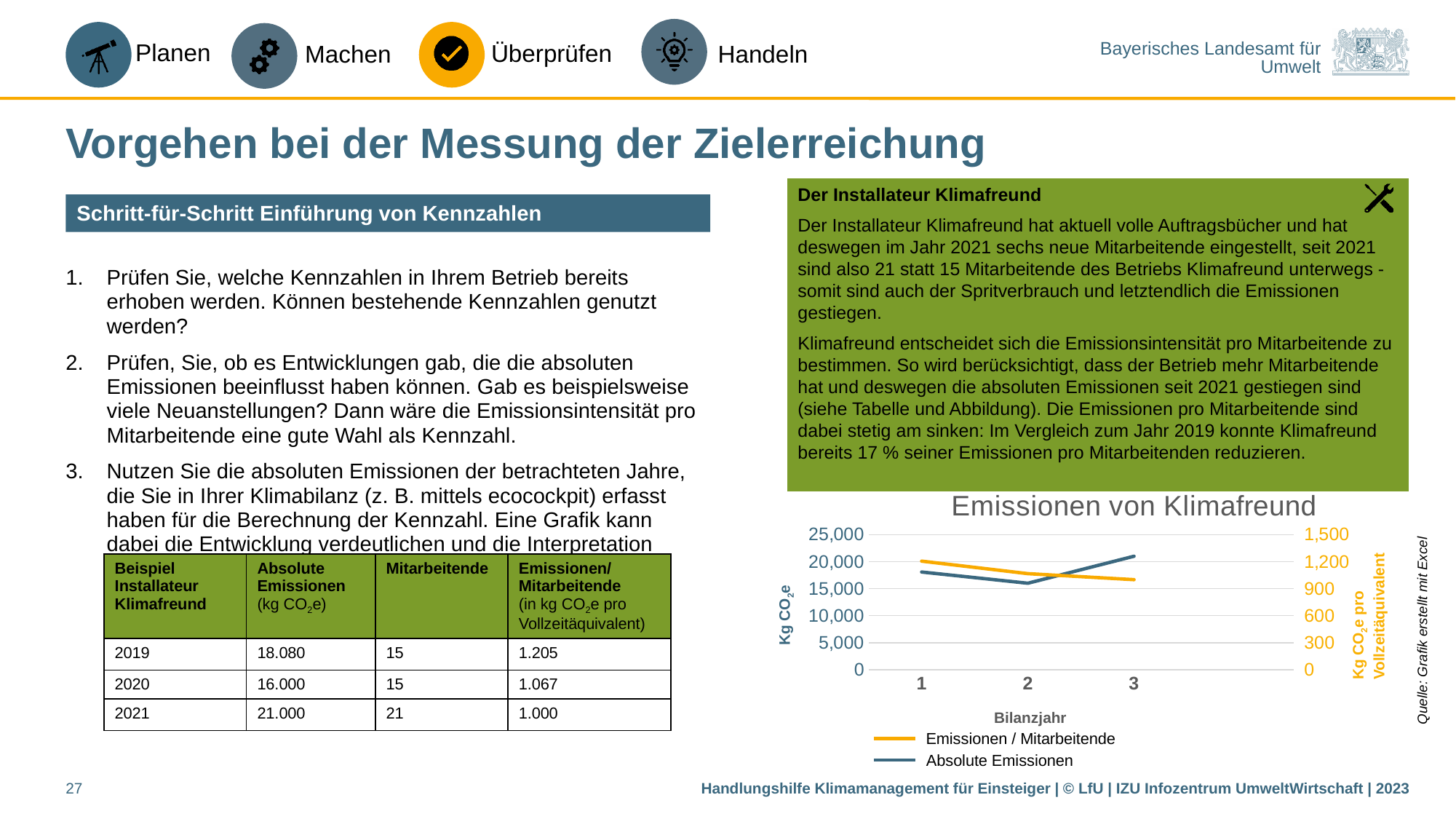
In the "Emissionen von Klimafreund" chart, is the "Emissionen / Mitarbeitende" value at Bilanzjahr 3 greater or less than 900? greater In the "Emissionen von Klimafreund" chart, what is the label of the x axis? Bilanzjahr In the "Emissionen von Klimafreund" chart, does the "Absolute Emissionen" line rise or fall from Bilanzjahr 2 to 3? rise In the "Emissionen von Klimafreund" chart, at which Bilanzjahr is "Absolute Emissionen" highest? 3 In the "Emissionen von Klimafreund" chart, is the "Absolute Emissionen" value at Bilanzjahr 3 greater or less than 20,000? greater How many series does the legend of the "Emissionen von Klimafreund" chart list? 2 How many Bilanzjahr points are plotted on the x axis of the "Emissionen von Klimafreund" chart? 3 In the "Emissionen von Klimafreund" chart, which is larger for "Absolute Emissionen": Bilanzjahr 1 or Bilanzjahr 3? Bilanzjahr 3 What type of chart is "Emissionen von Klimafreund"? line chart In the "Emissionen von Klimafreund" chart, is the "Absolute Emissionen" value at Bilanzjahr 2 greater or less than 20,000? less In the "Emissionen von Klimafreund" chart, at which Bilanzjahr is "Absolute Emissionen" lowest? 2 In the "Emissionen von Klimafreund" chart, does the "Emissionen / Mitarbeitende" line rise or fall from Bilanzjahr 1 to 3? fall